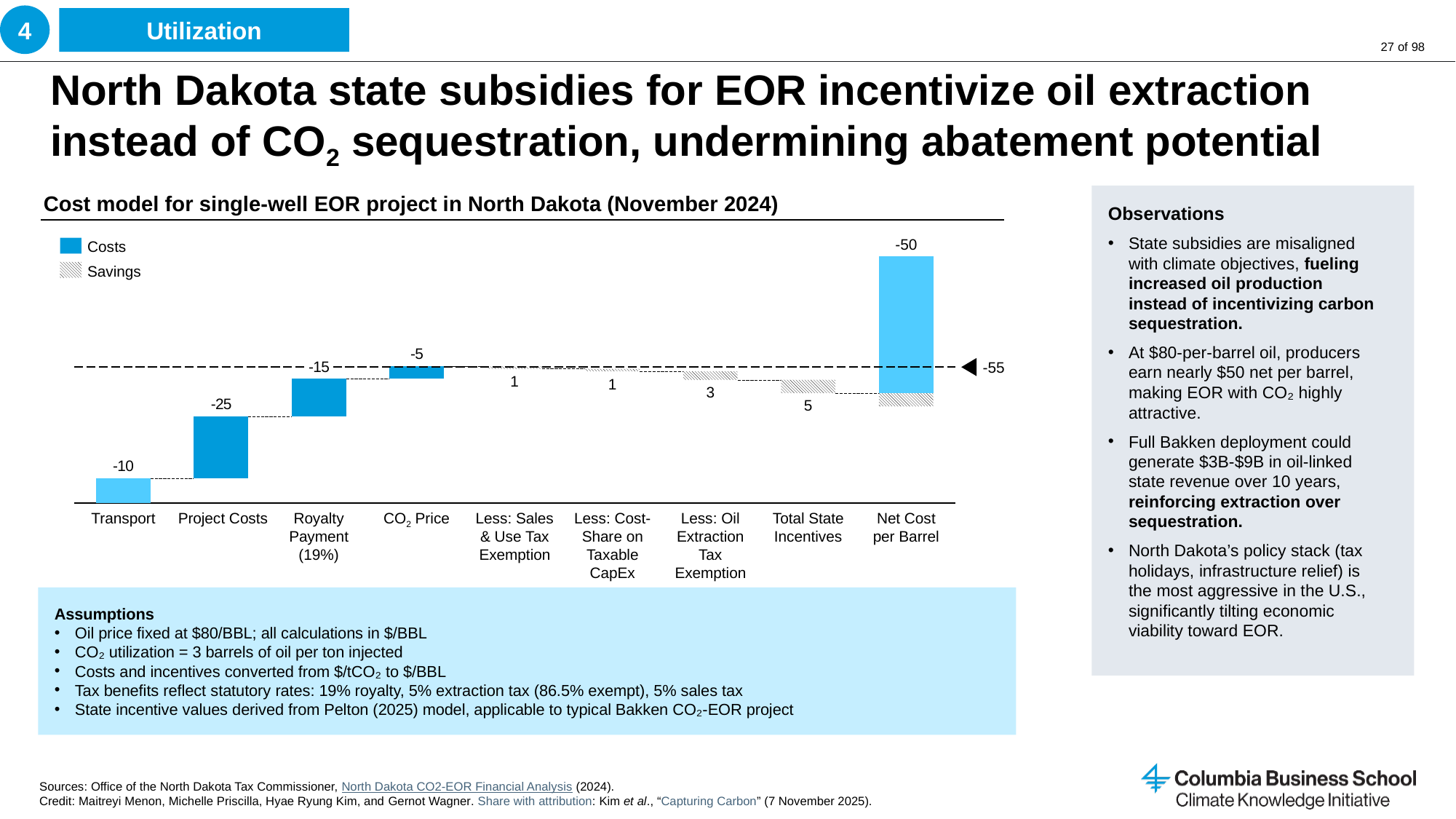
What value is marked by the dashed horizontal line with the arrow on the right side of the chart? -55 What is the value shown for Total State Incentives? 5 How many entries does the chart legend list? 2 How many categories are shown along the x axis of the chart? 9 What is the value shown for Royalty Payment (19%)? -15 Which is larger in magnitude: the Royalty Payment (19%) value or the CO2 Price value? Royalty Payment (19%) What is the value shown for Transport in the cost model chart? -10 What is the value shown for Net Cost per Barrel? -50 Which cost category has the largest negative value among Transport, Project Costs, Royalty Payment and CO2 Price? Project Costs What is the value shown for Project Costs? -25 What is the value shown for Less: Oil Extraction Tax Exemption? 3 What is the difference between the Project Costs value (-25) and the Transport value (-10)? 15